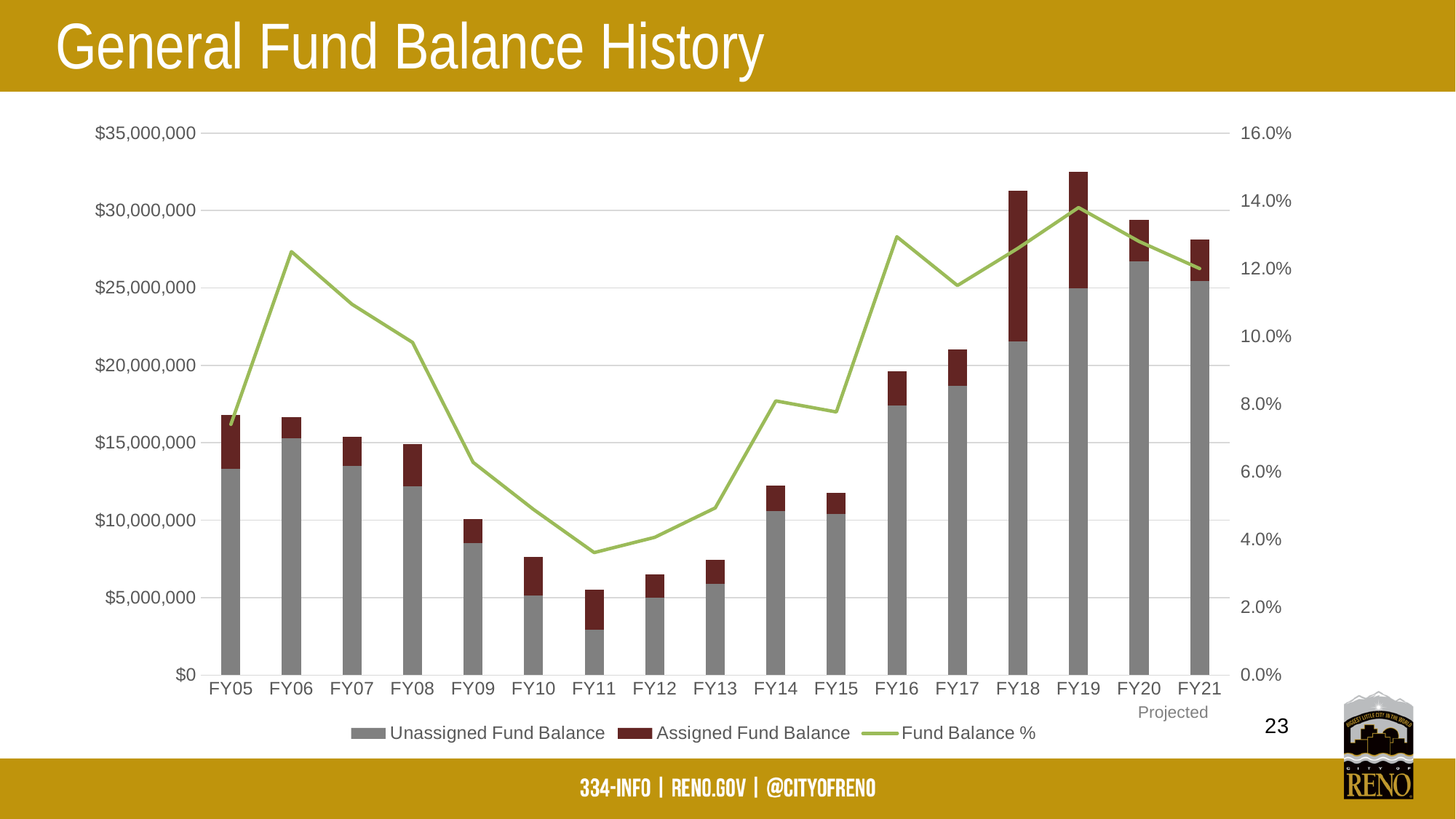
Which fiscal year has the lowest total fund balance (stacked bar)? FY11 How many series does the legend list? 3 Is the Fund Balance % for FY10 greater or less than 6.0%? less Which fiscal year has the highest Fund Balance %? FY19 Which fiscal year has the lowest Fund Balance %? FY11 Which is larger, the total fund balance for FY05 or for FY09? FY05 Do the total fund balances rise or fall from FY05 to FY11? fall How many fiscal years are shown on the x axis? 17 Is the total fund balance for FY18 greater or less than $30,000,000? greater Which fiscal year has the highest total fund balance (stacked bar)? FY19 Which fiscal year on the x axis is marked as Projected? FY21 What kind of chart is shown on the slide? A combination bar and line chart